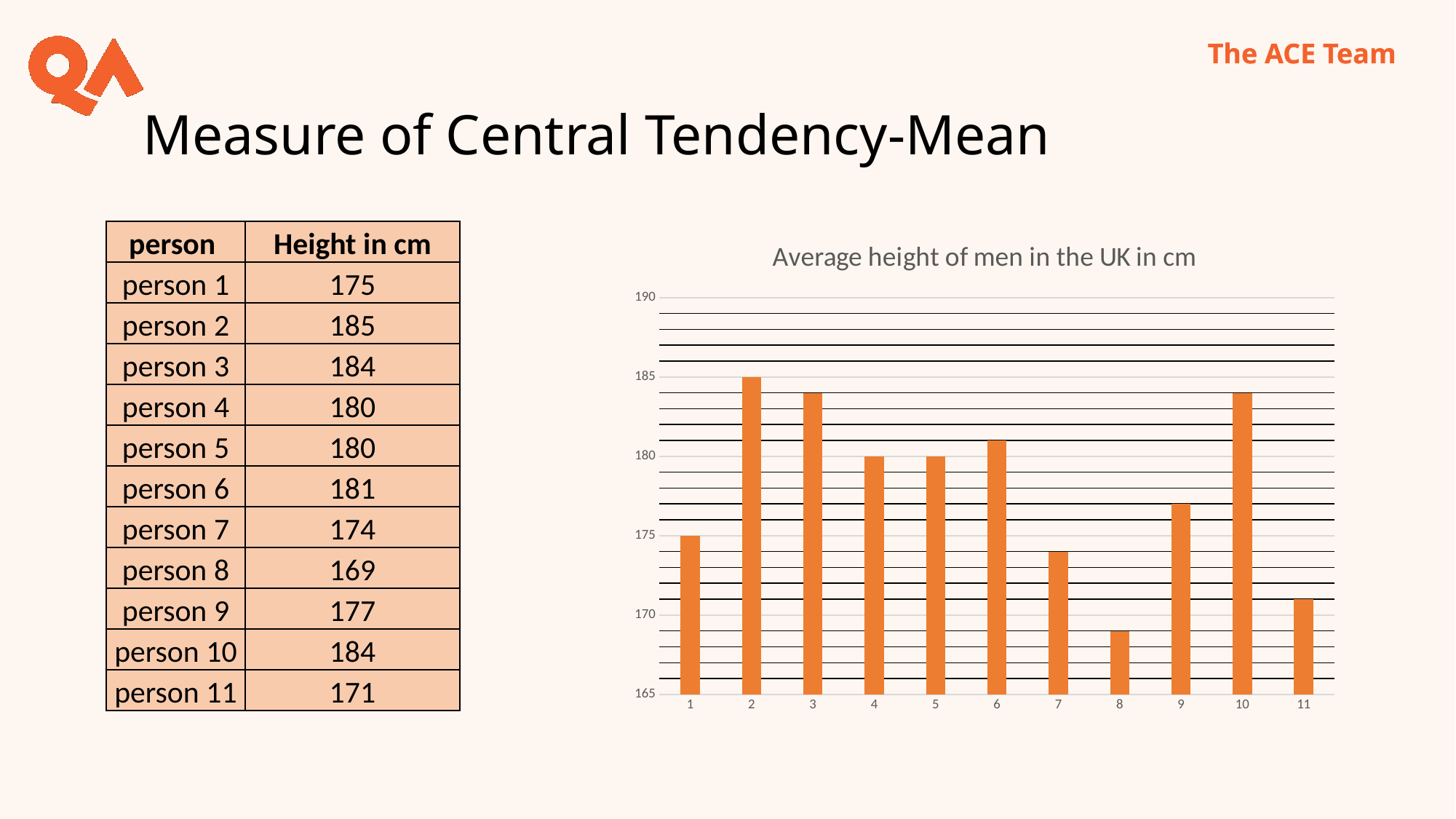
What is the title of the chart? Average height of men in the UK in cm How many bars are plotted in the chart? 11 What is the value of the bar for category 4? 180 What kind of chart is shown on the slide? bar chart Which is larger, the bar for category 2 or the bar for category 7? category 2 What is the difference between the values for category 2 and category 1? 10 What is the value of the bar for category 1? 175 Is the value for category 8 greater or less than 175? less Is the value for category 10 greater or less than 180? greater Which category has the lowest bar in the chart? 8 What is the value of the bar for category 2? 185 Is the value for category 9 greater or less than 175? greater